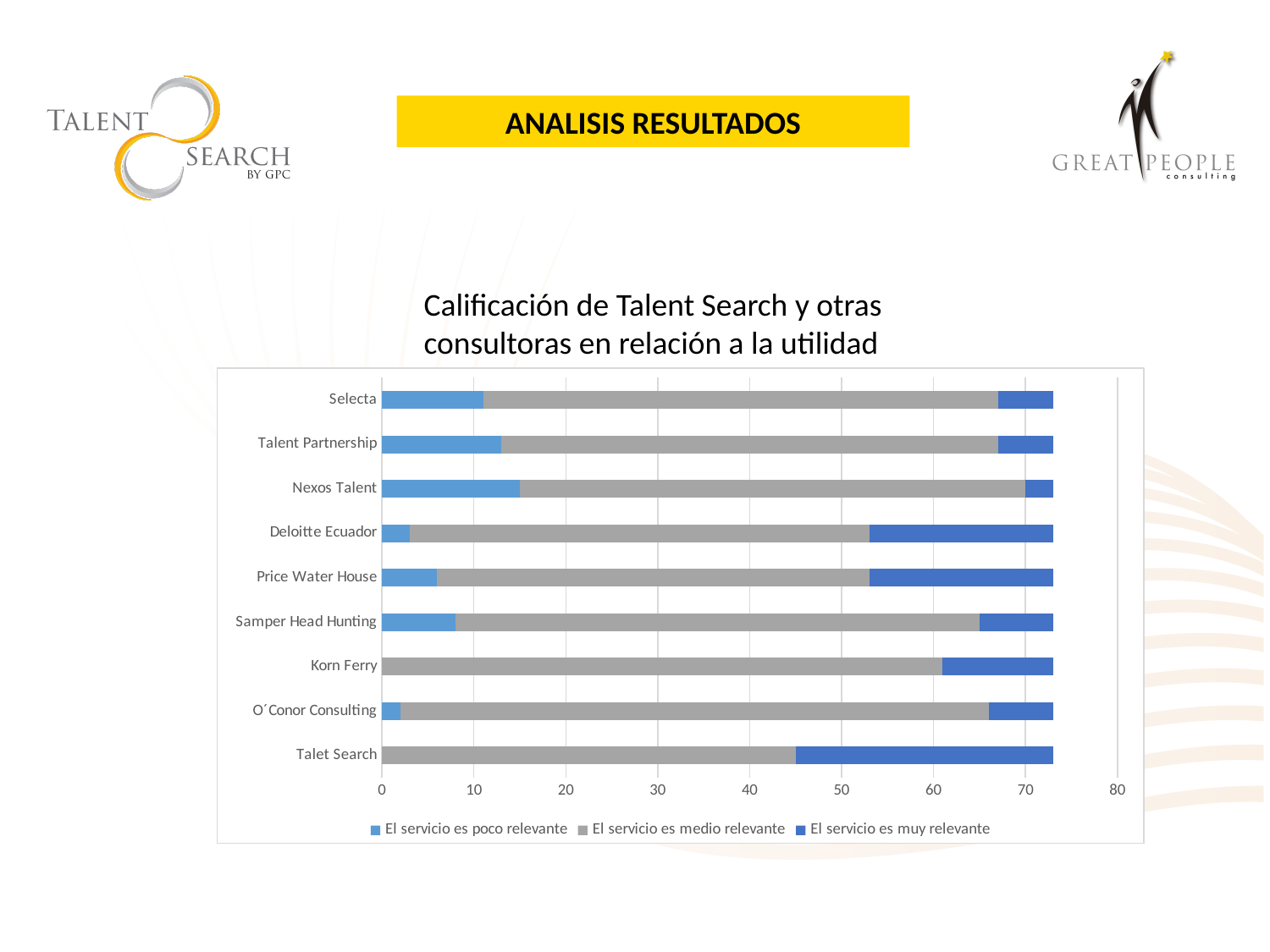
Which is larger: the 'El servicio es muy relevante' segment for Deloitte Ecuador or for Selecta? Deloitte Ecuador How many series does the chart legend list? 3 Which firm has the largest 'El servicio es poco relevante' segment? Nexos Talent Which firm has the largest 'El servicio es muy relevante' segment? Talet Search What kind of chart is shown on the slide? Stacked bar chart How many consulting firms (categories) are listed on the chart? 9 Is the 'El servicio es muy relevante' value for Talet Search greater or less than 20? greater What is the title of the chart? Calificación de Talent Search y otras consultoras en relación a la utilidad Is the 'El servicio es poco relevante' value for Deloitte Ecuador greater or less than 10? less Is the 'El servicio es medio relevante' value for Talet Search greater or less than 50? less Which series is shown in grey in the chart legend? El servicio es medio relevante Which firm has the smallest 'El servicio es muy relevante' segment? Nexos Talent